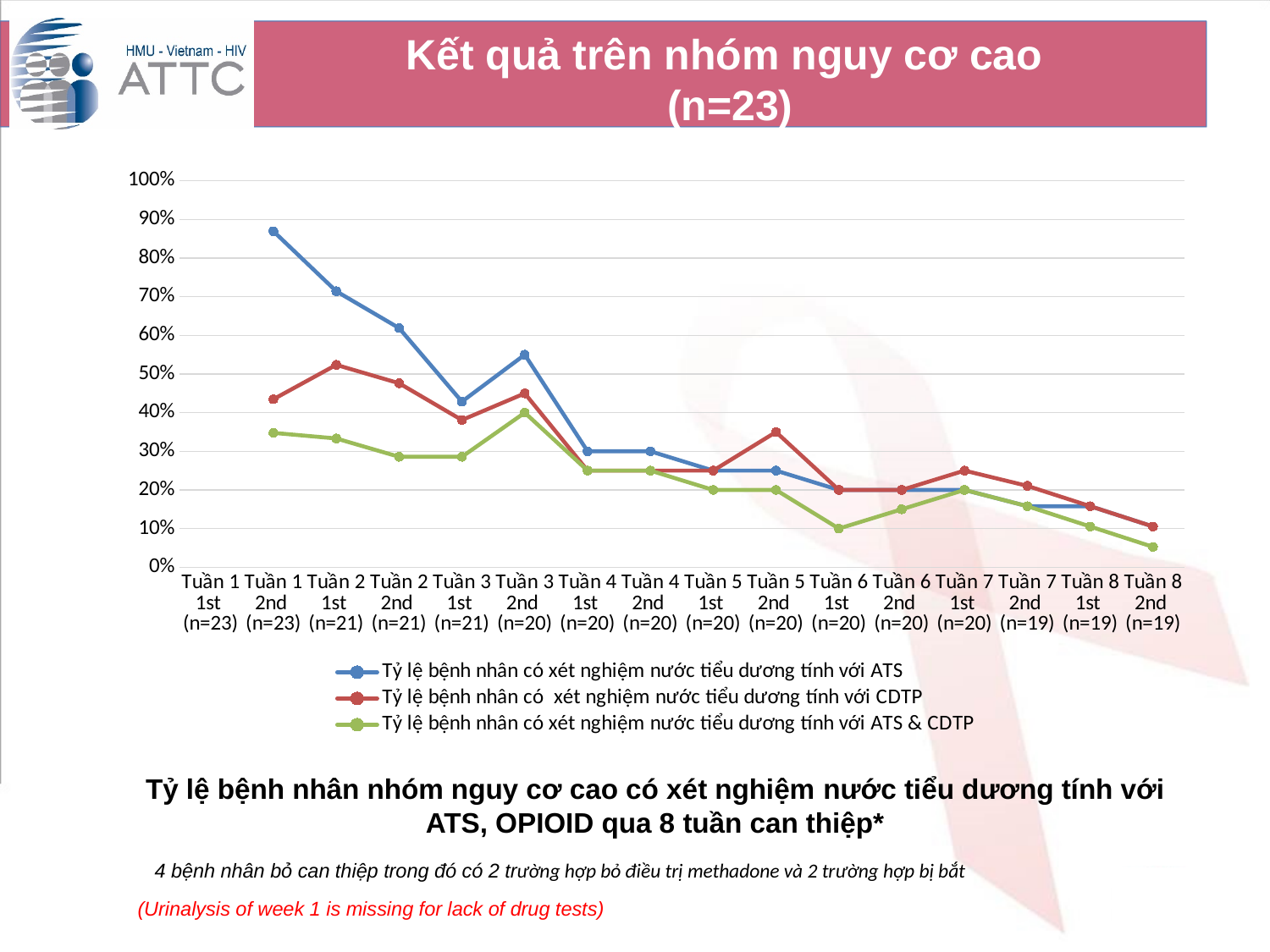
Does the ATS series generally rise or fall from Tuần 1 to Tuần 8? fall At which time point is the ATS & CDTP series at its lowest? Tuần 8 2nd (n=19) Is the value for 'Tỷ lệ bệnh nhân có xét nghiệm nước tiểu dương tính với ATS' at Tuần 2 1st greater or less than 60%? greater At which time point is the ATS series at its highest? Tuần 1 2nd (n=23) How many series does the legend list? 3 Is the value for 'Tỷ lệ bệnh nhân có xét nghiệm nước tiểu dương tính với CDTP' at Tuần 5 2nd greater or less than 30%? greater What kind of chart is shown on the slide? line chart How many time points are shown along the x axis? 16 Is the value for 'Tỷ lệ bệnh nhân có xét nghiệm nước tiểu dương tính với ATS & CDTP' at Tuần 8 2nd greater or less than 10%? less